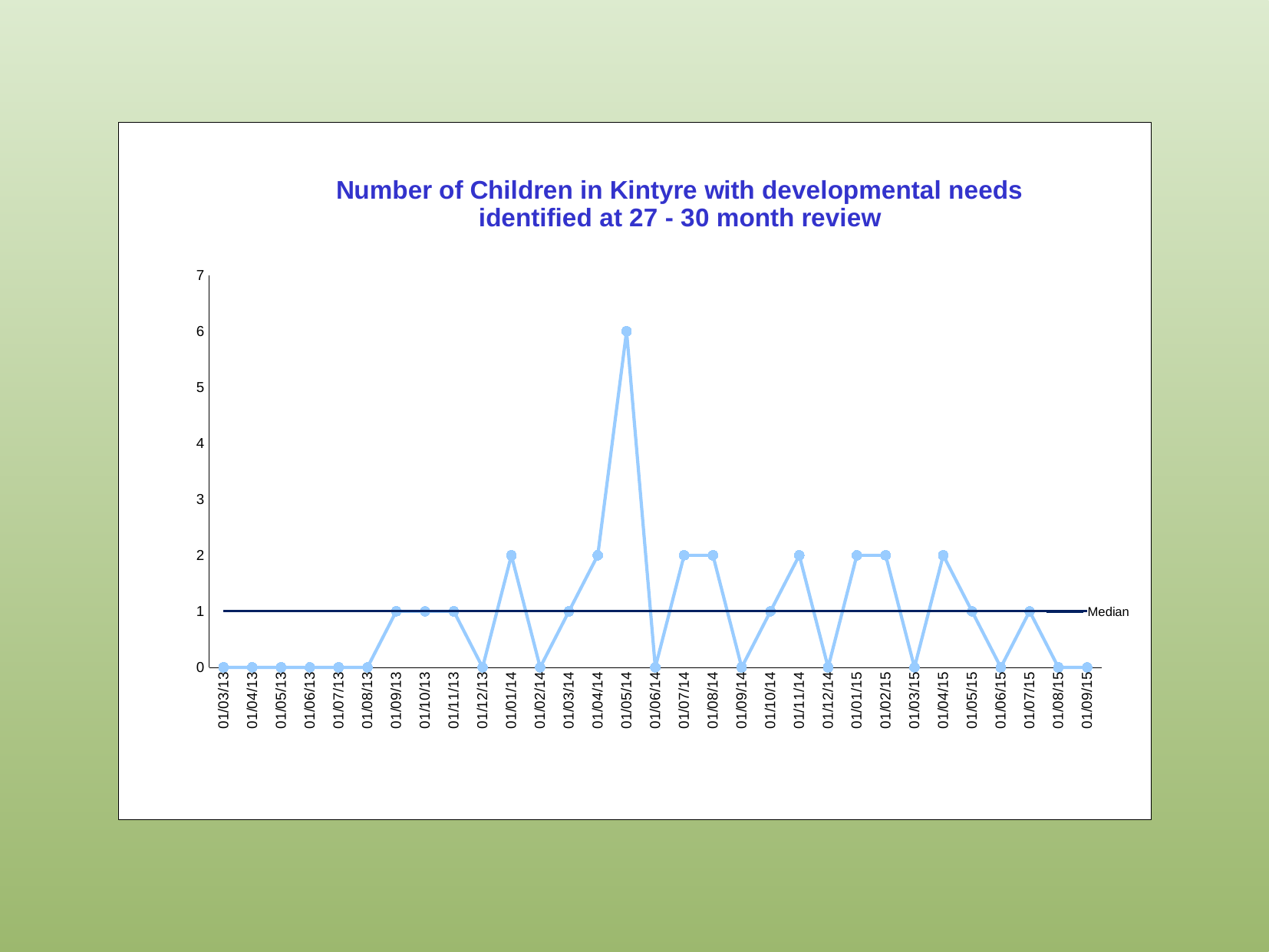
What is the value for 01/09/15? 0 How many data points are plotted on the line? 31 What is the value for 01/10/14? 1 Is the value for 01/05/14 greater or less than 5? greater What is the value for 01/05/14? 6 What is the difference between the values for 01/05/14 and 01/04/14? 4 What type of chart is shown on the slide? line chart At what value is the Median line drawn? 1 What is the title of the chart? Number of Children in Kintyre with developmental needs identified at 27 - 30 month review Which date has the highest value? 01/05/14 What is the value for 01/01/14? 2 Which is larger, the value for 01/11/14 or the value for 01/12/14? 01/11/14